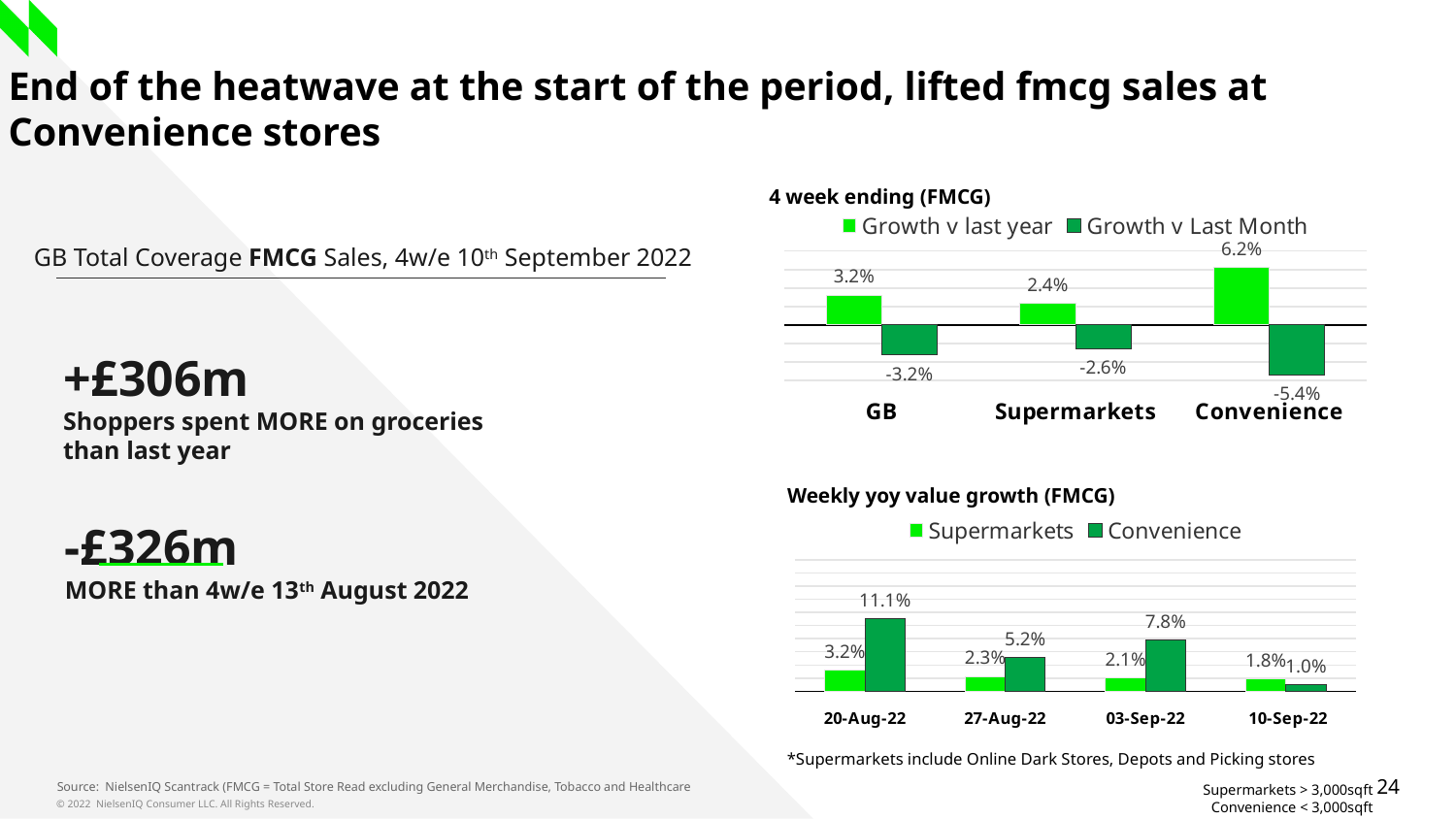
In the '4 week ending (FMCG)' chart, which category has the lowest Growth v Last Month? Convenience In the '4 week ending (FMCG)' chart, what is the Growth v Last Month value for Supermarkets? -2.6% In the 'Weekly yoy value growth (FMCG)' chart, what is the Supermarkets value for 27-Aug-22? 2.3% In the 'Weekly yoy value growth (FMCG)' chart, which week has the highest Convenience value? 20-Aug-22 How many series does the legend of the '4 week ending (FMCG)' chart list? 2 In the 'Weekly yoy value growth (FMCG)' chart, how many weeks are shown on the x axis? 4 In the 'Weekly yoy value growth (FMCG)' chart, do the Supermarkets values rise or fall from 20-Aug-22 to 10-Sep-22? fall In the 'Weekly yoy value growth (FMCG)' chart, what is the Convenience value for 03-Sep-22? 7.8% In the '4 week ending (FMCG)' chart, what is the difference between the Growth v last year values for Convenience and GB? 3.0% In the '4 week ending (FMCG)' chart, what is the Growth v last year value for Convenience? 6.2% What kind of chart is the 'Weekly yoy value growth (FMCG)' chart? bar chart In the '4 week ending (FMCG)' chart, which category has the highest Growth v last year? Convenience